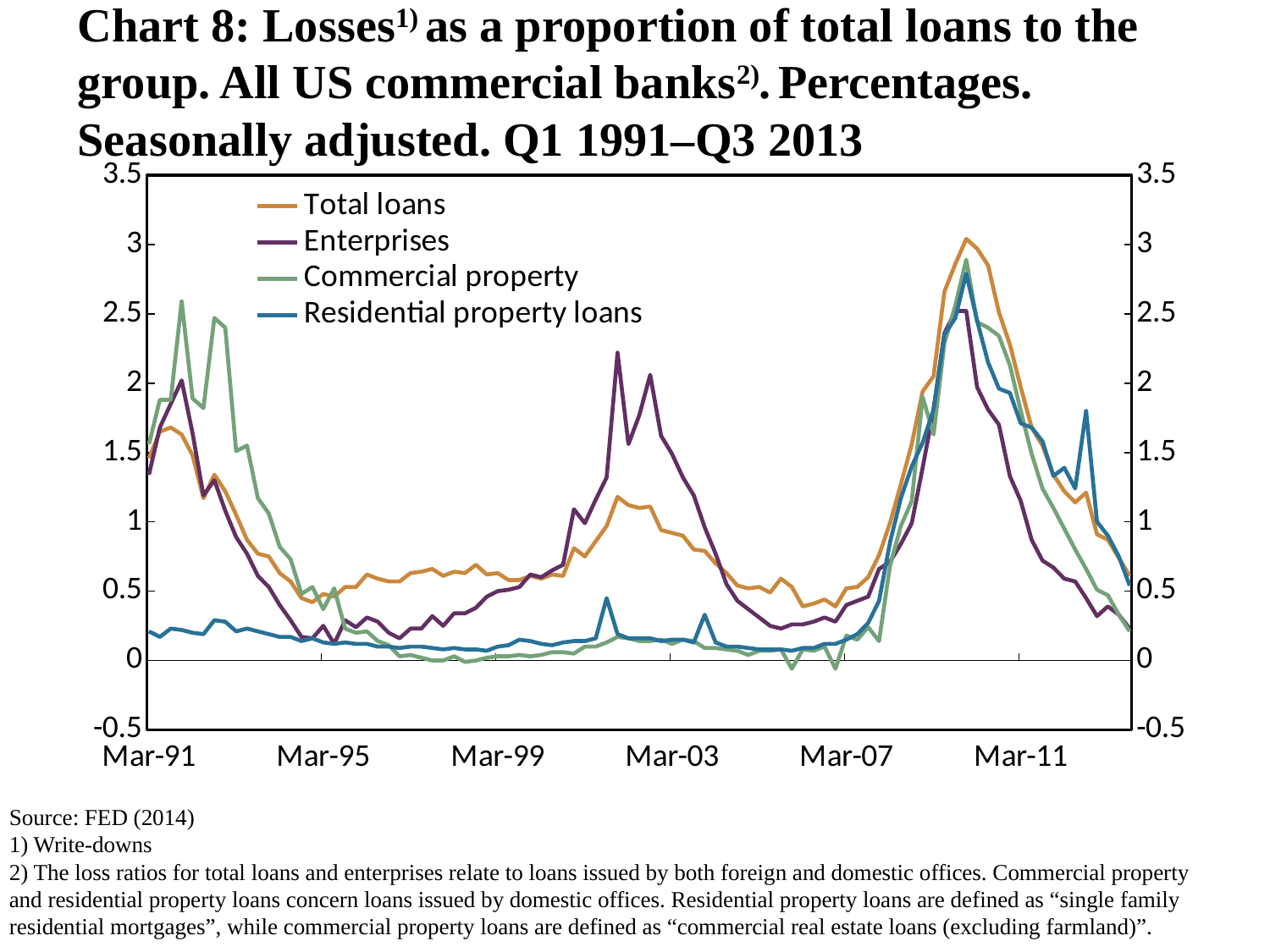
Does the Enterprises series rise or fall from Mar-91 to Mar-95? Fall What kind of chart is shown on the slide? Line chart Which series has the highest value at Mar-07? Total loans Is the peak value of Total loans around 2010 greater or less than 2.5? greater Which series are listed in the legend? Total loans, Enterprises, Commercial property, Residential property loans Which series reaches the highest value around Mar-03 (the peak near 2002)? Enterprises Does the Total loans series rise or fall from Mar-11 to the end of the period? Fall How many series does the legend list? 4 Is the value for Residential property loans at Mar-99 greater or less than 0.5? less Which series reaches the highest peak around 2010? Total loans What is the source given for the chart? FED (2014)